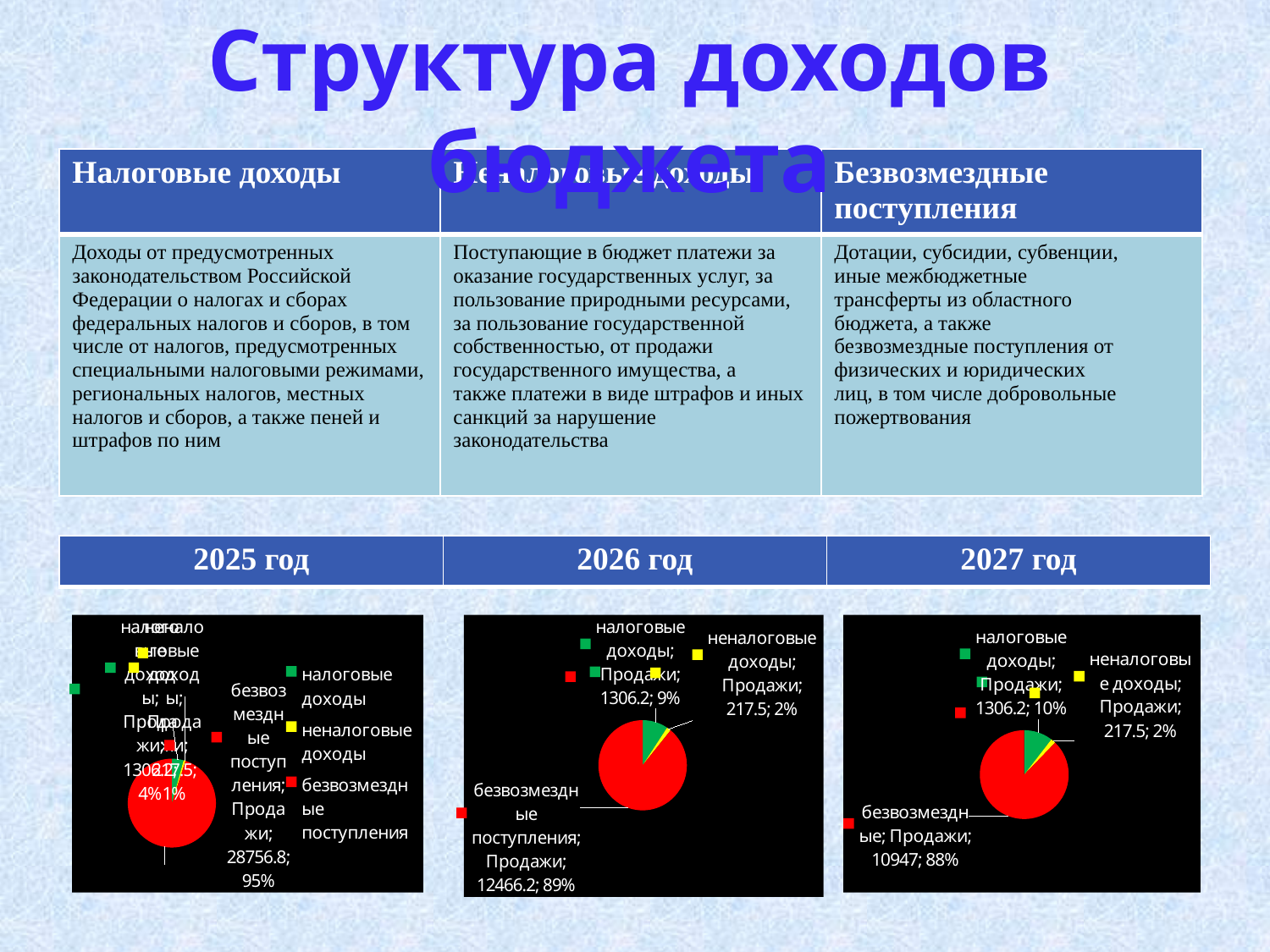
In the 2027 год chart, what value is shown for неналоговые доходы? 217.5 How many entries does the legend of the 2025 год chart list? 3 In the 2026 год chart, what share of the pie is безвозмездные поступления? 89% In the 2027 год chart, what share of the pie is налоговые доходы? 10% In the 2025 год chart, what share of the pie is безвозмездные поступления? 95% In the 2027 год chart, what value is shown for безвозмездные поступления? 10947 In the 2027 год chart, which category has the smallest slice? неналоговые доходы In the 2026 год chart, which category has the largest slice? безвозмездные поступления What kind of chart is used for the 2026 год chart? pie chart In the 2026 год chart, what is the difference between the values for налоговые доходы and неналоговые доходы? 1088.7 In the 2026 год chart, what value is shown for налоговые доходы? 1306.2 In the 2026 год chart, what value is shown for безвозмездные поступления? 12466.2